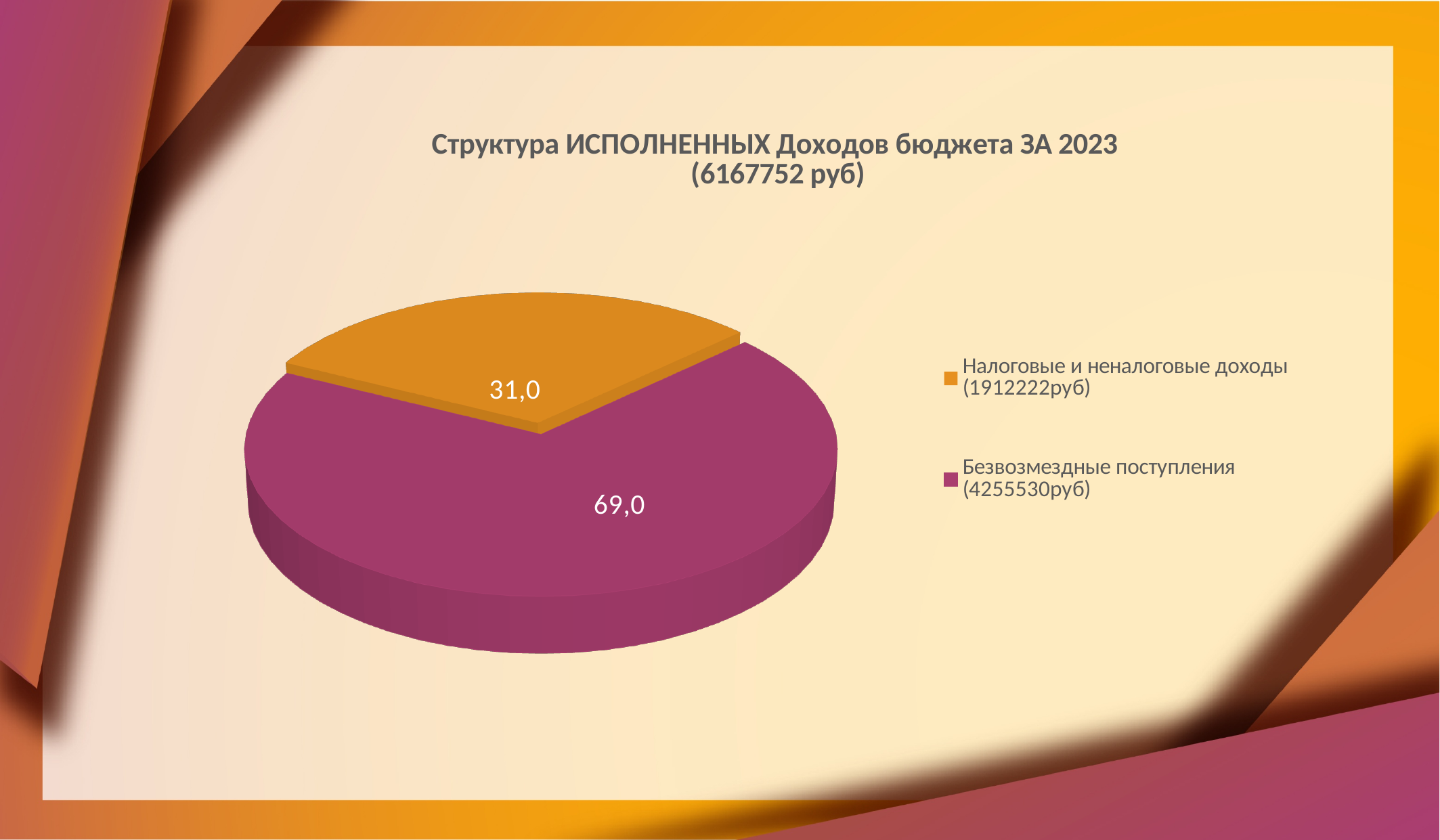
Which slice of the pie chart is the smallest? Налоговые и неналоговые доходы (1912222руб) What is the value shown for the slice "Налоговые и неналоговые доходы (1912222руб)"? 31,0 What is the total of the two slice values shown on the pie chart? 100,0 How many slices does the pie chart have? 2 What is the difference between the values of the two slices, 69,0 and 31,0? 38,0 What colour is the slice for "Безвозмездные поступления (4255530руб)"? Magenta (purple-pink) What type of chart is shown on the slide? Pie chart What is the title of the chart? Структура ИСПОЛНЕННЫХ Доходов бюджета ЗА 2023 (6167752 руб) How many entries does the legend list? 2 Which slice of the pie chart is the largest? Безвозмездные поступления (4255530руб) What is the value shown for the slice "Безвозмездные поступления (4255530руб)"? 69,0 Which is larger: the slice for "Налоговые и неналоговые доходы" or the slice for "Безвозмездные поступления"? Безвозмездные поступления